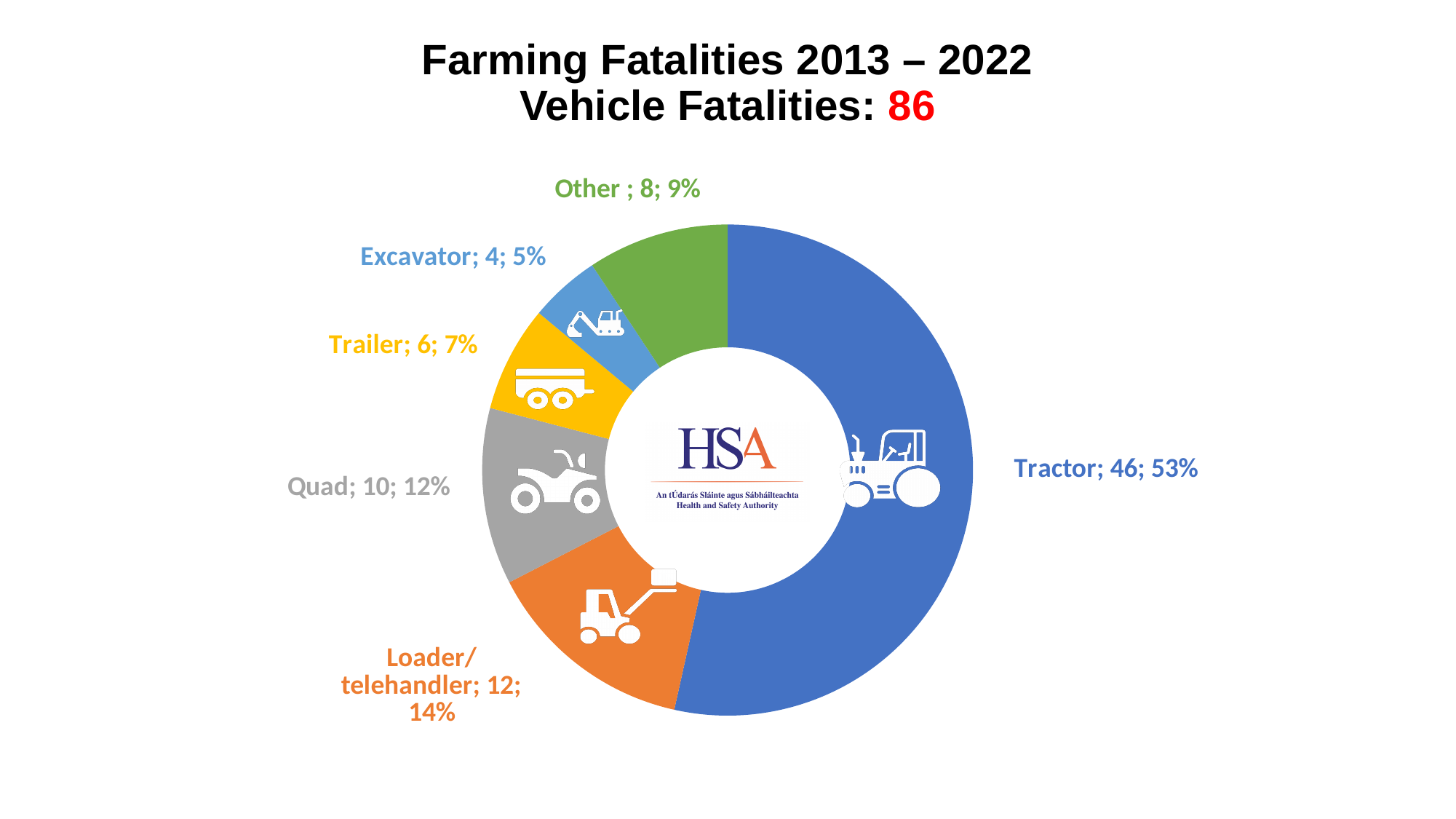
How many categories are shown in the chart? 6 Which vehicle category has the highest number of fatalities? Tractor Which vehicle category has the lowest number of fatalities? Excavator How many vehicle fatalities are attributed to tractors? 46 How many fatalities are shown for Loader/telehandler? 12 What kind of chart is shown on the slide? Pie chart (doughnut) What is the difference in fatalities between Tractor and Quad? 36 Which has more fatalities, Trailer or Other? Other What percentage of vehicle fatalities does the Quad slice represent? 12% What share of vehicle fatalities does the Excavator slice represent? 5% What is the total number of vehicle fatalities stated in the title? 86 What colour is the Trailer slice? Yellow